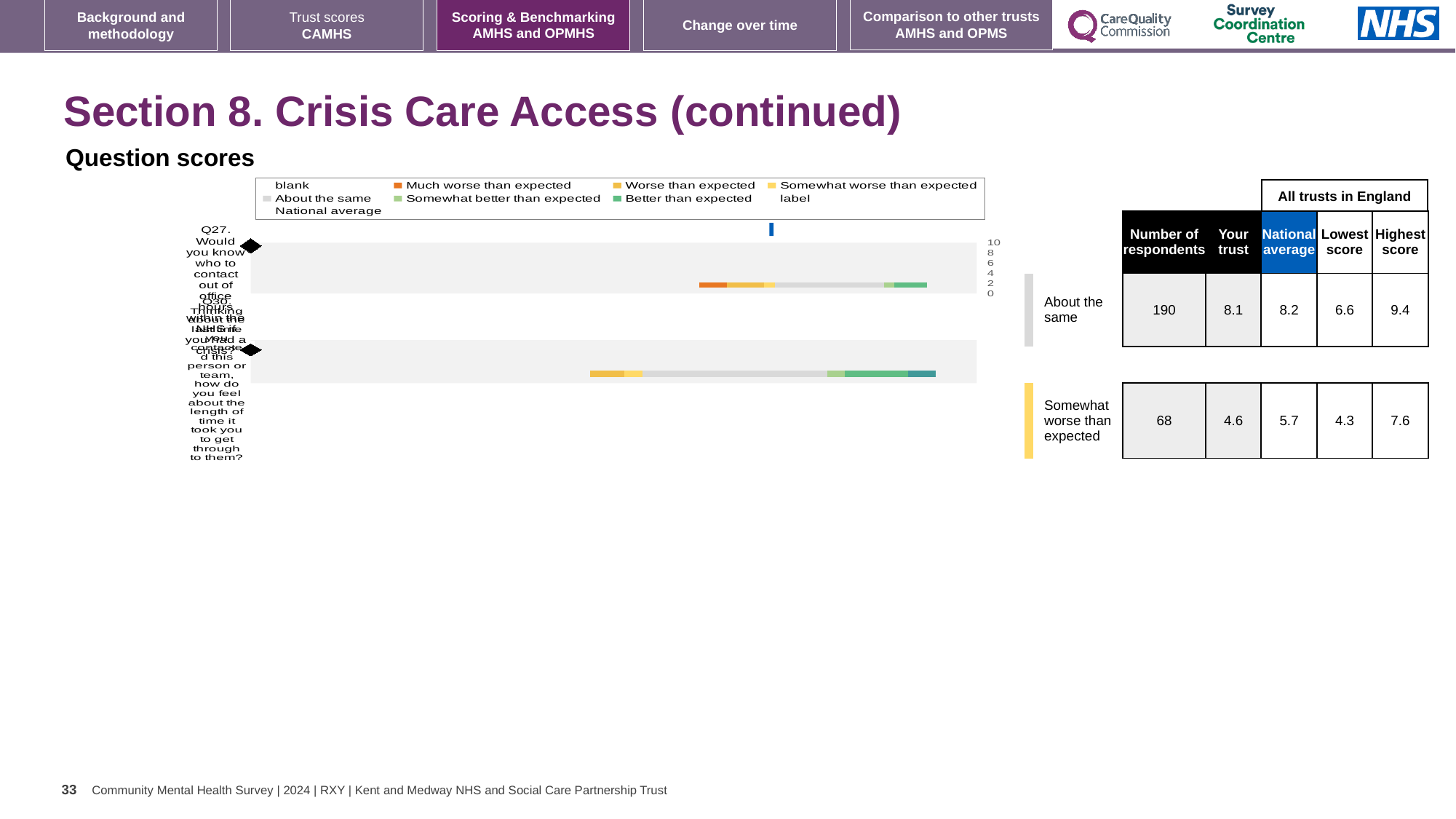
What is the difference between the national average (5.7) and the "Your trust" score (4.6) for Q30? 1.1 What kind of chart is shown under "Question scores"? bar chart How many questions (categories) are plotted in the Question scores chart? 2 What is the "Your trust" score for Q27 (Would you know who to contact out of office hours)? 8.1 For Q27, which is larger: the "Your trust" score or the national average? National average What is the national average score for Q30 (how do you feel about the length of time it took you to get through to them)? 5.7 In the legend of the Question scores chart, what colour represents "Much worse than expected"? orange How many entries does the legend of the Question scores chart list? 9 What is the highest score among all trusts in England for Q27? 9.4 What is the title shown above the chart? Question scores How many respondents answered Q30? 68 Which benchmark category is Q30 rated as? Somewhat worse than expected